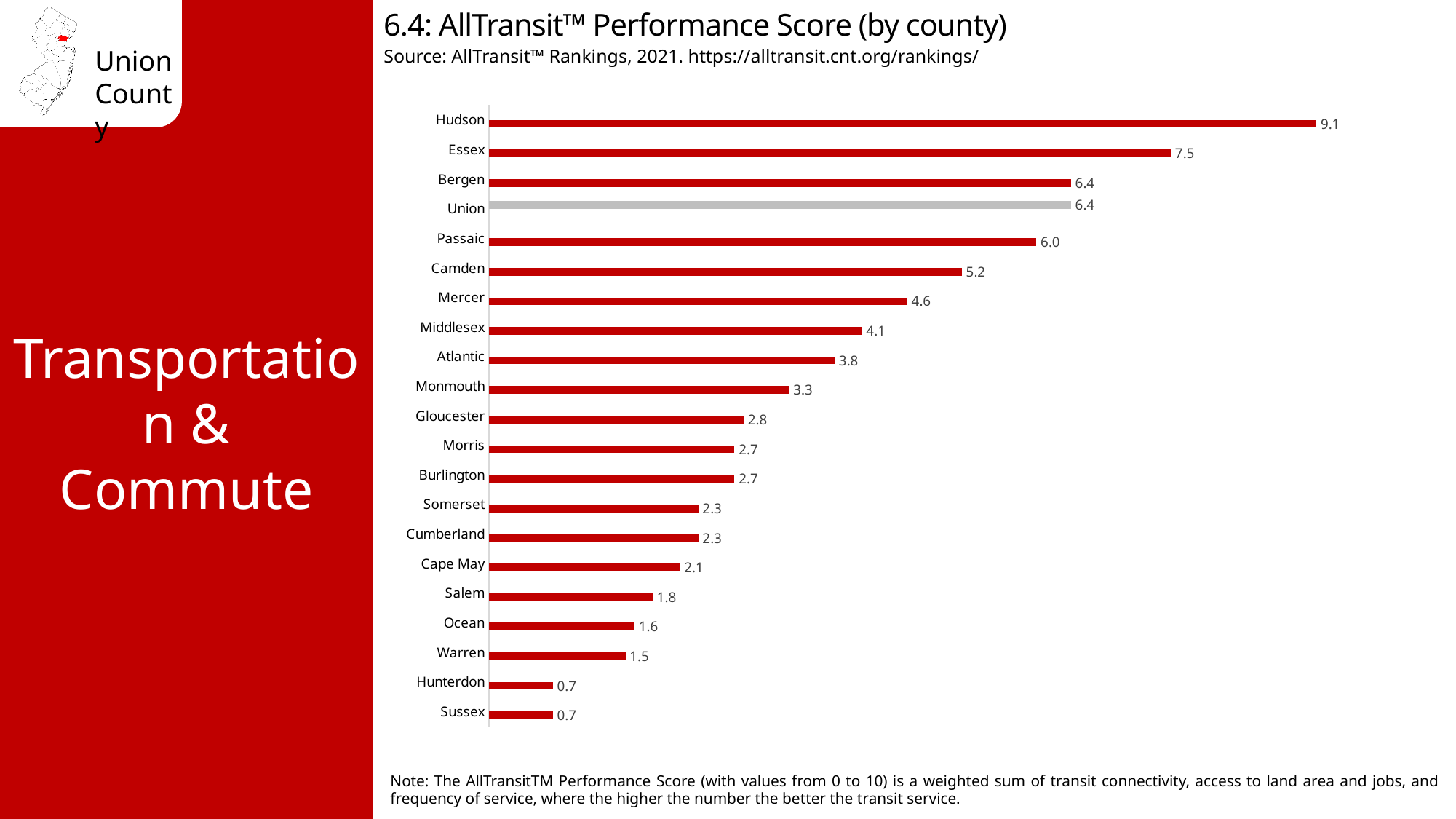
What type of chart is used to show the AllTransit Performance Scores? Bar chart What is the difference between the scores of Hudson and Essex counties? 1.6 What is the AllTransit Performance Score for Union County? 6.4 Which county's bar is shown in gray instead of red? Union What is the difference between the scores of Union and Passaic counties? 0.4 Which county has the highest AllTransit Performance Score? Hudson What is the AllTransit Performance Score for Mercer County? 4.6 How many counties are shown in the chart? 21 What is the AllTransit Performance Score for Cape May County? 2.1 Which county has a higher score, Monmouth or Atlantic? Atlantic Which county has a higher score, Camden or Middlesex? Camden What is the AllTransit Performance Score for Hudson County? 9.1